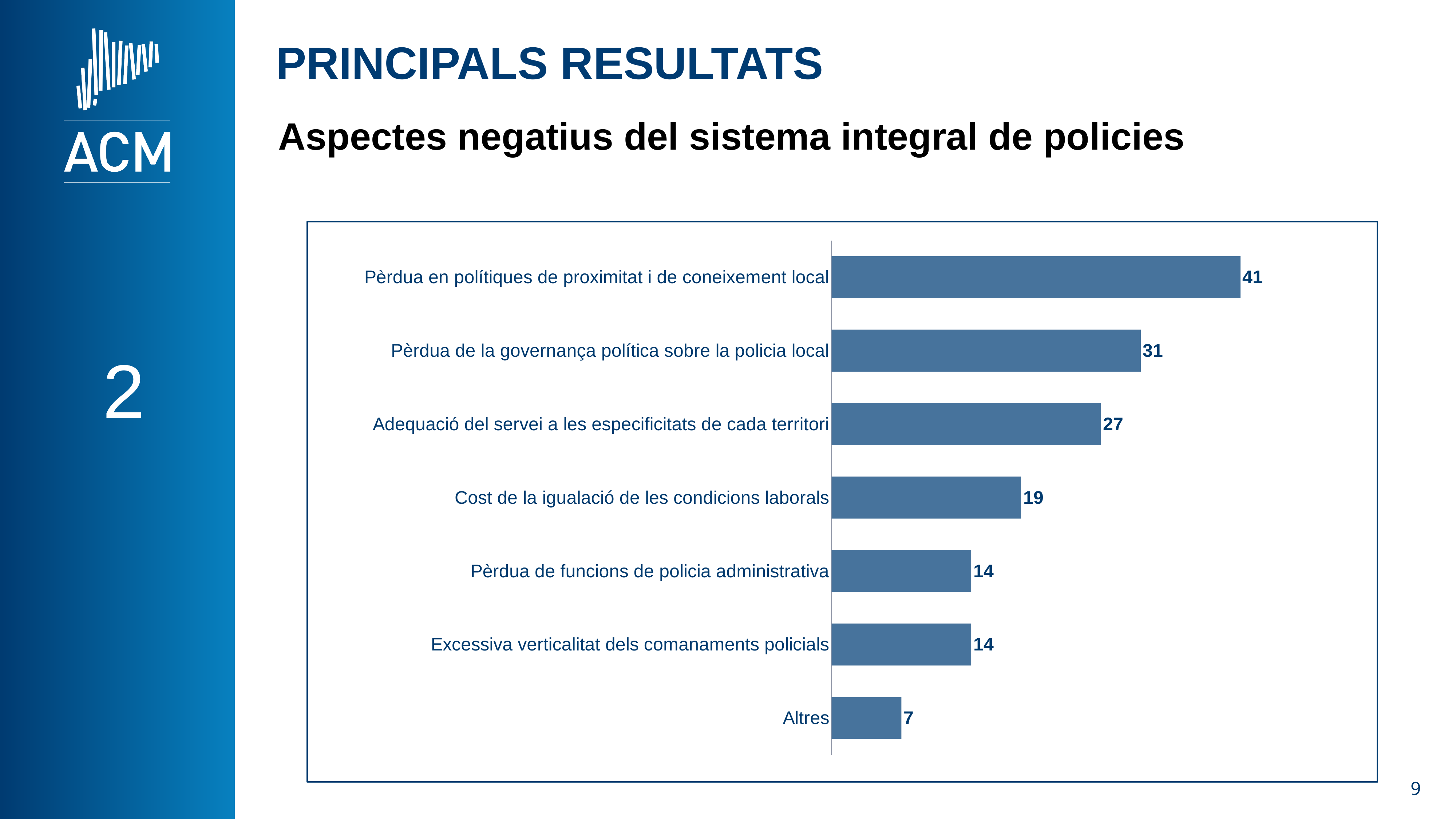
What is the value for "Adequació del servei a les especificitats de cada territori"? 27 What is the difference between the values for "Adequació del servei a les especificitats de cada territori" and "Cost de la igualació de les condicions laborals"? 8 How many categories are shown in the chart? 7 What is the subtitle above the chart? Aspectes negatius del sistema integral de policies What is the value for "Cost de la igualació de les condicions laborals"? 19 What is the value for "Altres"? 7 Which category has the highest value? Pèrdua en polítiques de proximitat i de coneixement local What kind of chart is shown on the slide? Bar chart What is the difference between the values for "Pèrdua en polítiques de proximitat i de coneixement local" and "Pèrdua de la governança política sobre la policia local"? 10 What is the value for "Pèrdua en polítiques de proximitat i de coneixement local"? 41 Which is larger: the value for "Pèrdua de la governança política sobre la policia local" or for "Adequació del servei a les especificitats de cada territori"? Pèrdua de la governança política sobre la policia local Which category has the lowest value? Altres